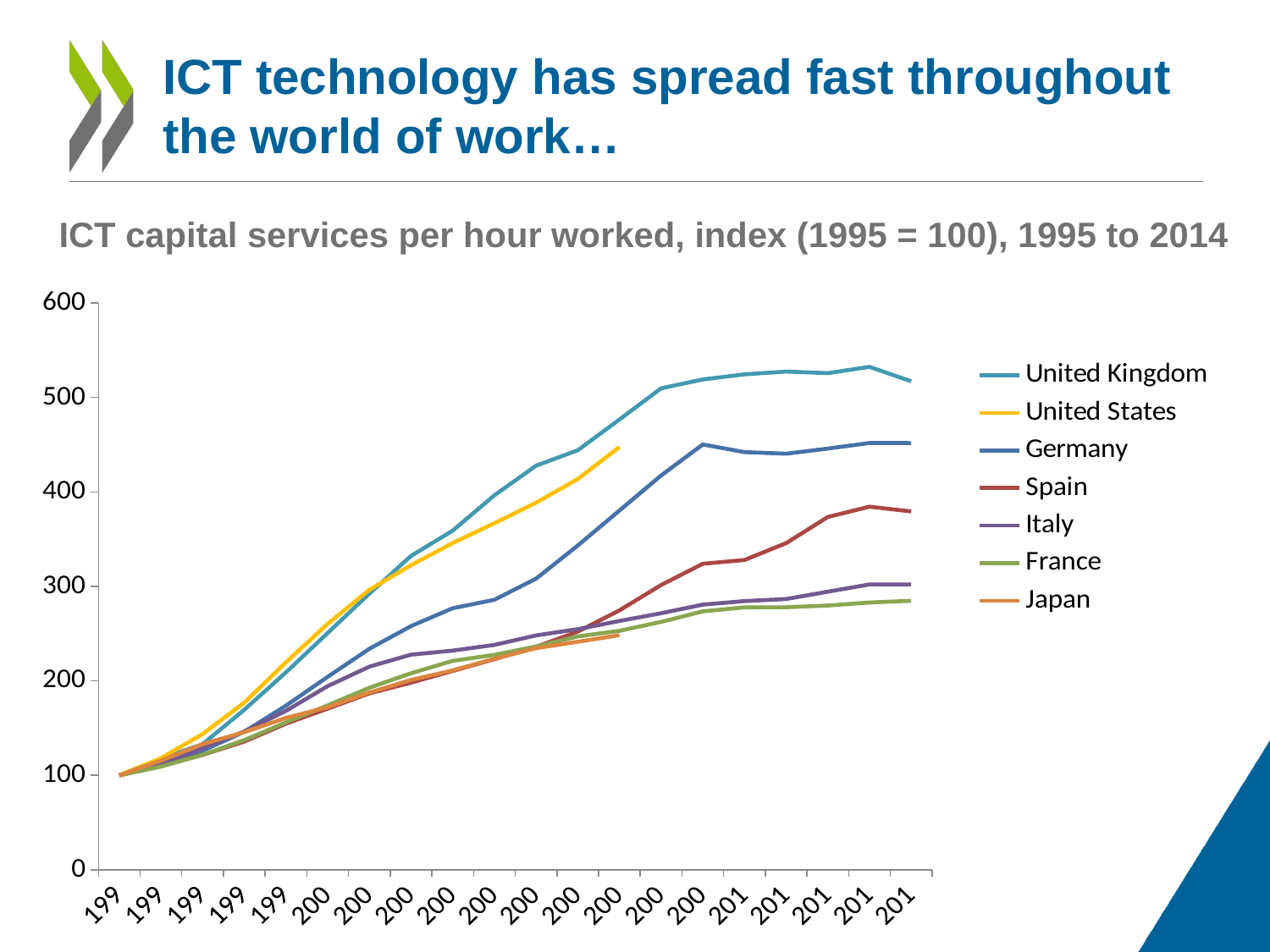
Is the final value for the United Kingdom greater or less than 500? greater Which country has the lowest index value at the end of the period (2014)? France Is the final value for Germany greater or less than 400? greater What is the index value for every country in the base year 1995? 100 What colour is the line for the United States? yellow How many series does the legend list? 7 Does the United Kingdom line generally rise or fall from 1995 to 2014? rise Is the final value for Spain greater or less than 400? less Which country has the highest ICT capital services index at the end of the period (2014)? United Kingdom At the end of the period, which is larger: the value for Germany or the value for Spain? Germany What kind of chart is shown on the slide? line chart